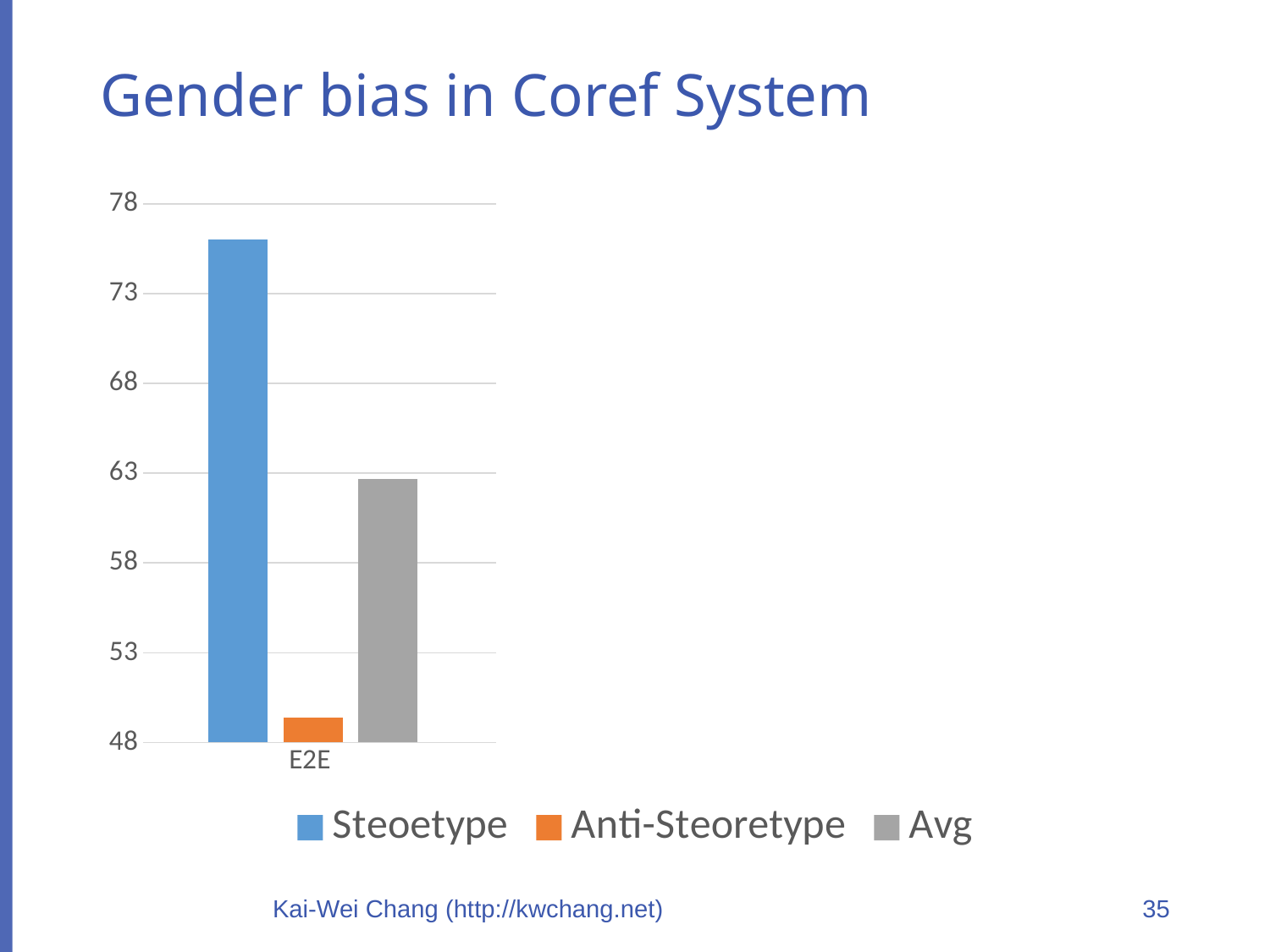
Which is larger for E2E, the Steoetype value or the Avg value? Steoetype Is the Steoetype value for E2E greater or less than 73? greater What is the title of the slide containing the chart? Gender bias in Coref System Is the Anti-Steoretype value for E2E greater or less than 53? less Is the Avg value for E2E greater or less than 58? greater What kind of chart is shown on the slide? bar chart How many categories are shown on the x axis? 1 Which series has the highest value for E2E? Steoetype How many series does the legend list? 3 Which is larger for E2E, the Avg value or the Anti-Steoretype value? Avg What colour are the Avg bars in the chart? gray Which series has the lowest value for E2E? Anti-Steoretype